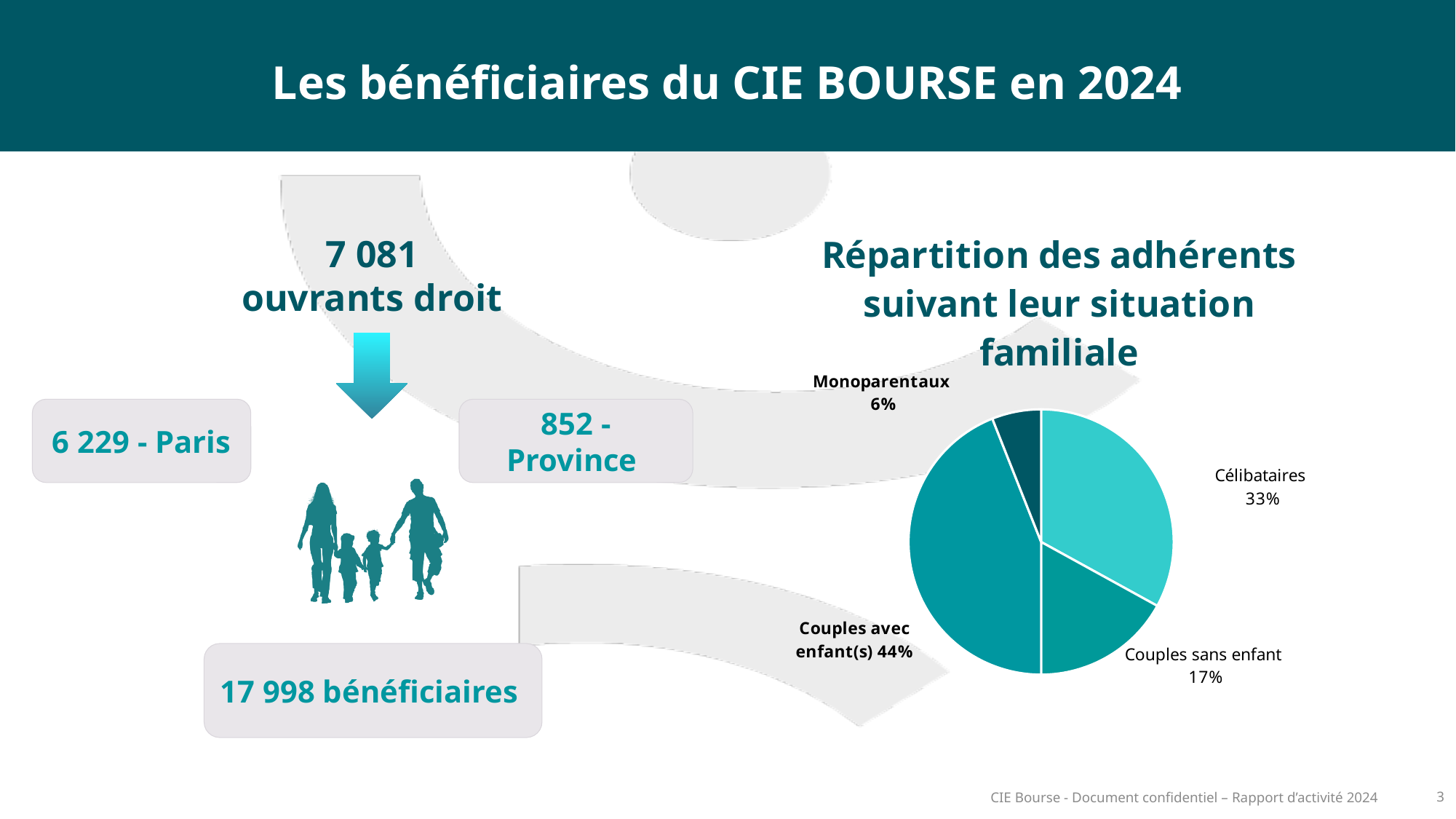
Which is larger in the pie chart: Couples sans enfant or Monoparentaux? Couples sans enfant Which category has the smallest slice of the pie chart? Monoparentaux What share of the pie chart is Couples sans enfant? 17% What is the combined share of Célibataires and Couples sans enfant in the pie chart? 50% What share of the pie chart is Couples avec enfant(s)? 44% What kind of chart is shown on the slide? Pie chart Which category has the largest slice of the pie chart? Couples avec enfant(s) What is the difference in percentage points between Couples avec enfant(s) and Célibataires? 11 What share of the pie chart is Célibataires? 33% How many categories does the pie chart show? 4 What share of the pie chart is Monoparentaux? 6% What is the title of the pie chart? Répartition des adhérents suivant leur situation familiale